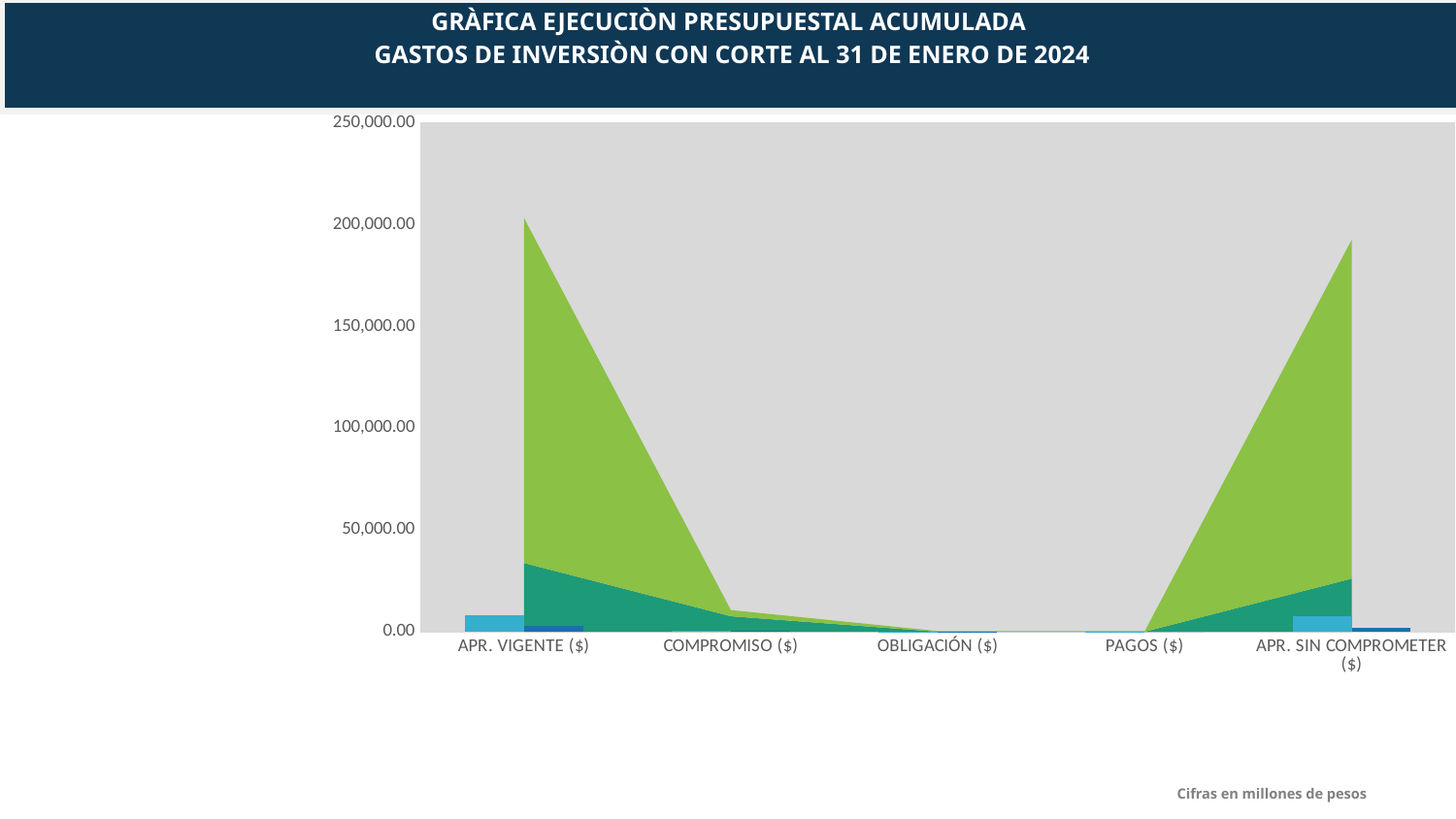
Which has a larger green area value, APR. VIGENTE ($) or COMPROMISO ($)? APR. VIGENTE ($) What kind of chart is shown on the slide? Combined area and bar chart Is the top of the green area for COMPROMISO ($) greater or less than 50,000.00? less What is the highest value shown on the vertical axis of the chart? 250,000.00 According to the note on the slide, in what units are the figures expressed? Millones de pesos Is the top of the teal area for APR. VIGENTE ($) greater or less than 50,000.00? less Is the top of the green area for APR. SIN COMPROMETER ($) greater or less than 150,000.00? greater Which category has the highest value for the top (green) area series? APR. VIGENTE ($) How many categories are shown on the x axis of the chart? 5 Do the area values rise or fall from APR. VIGENTE ($) to PAGOS ($)? fall